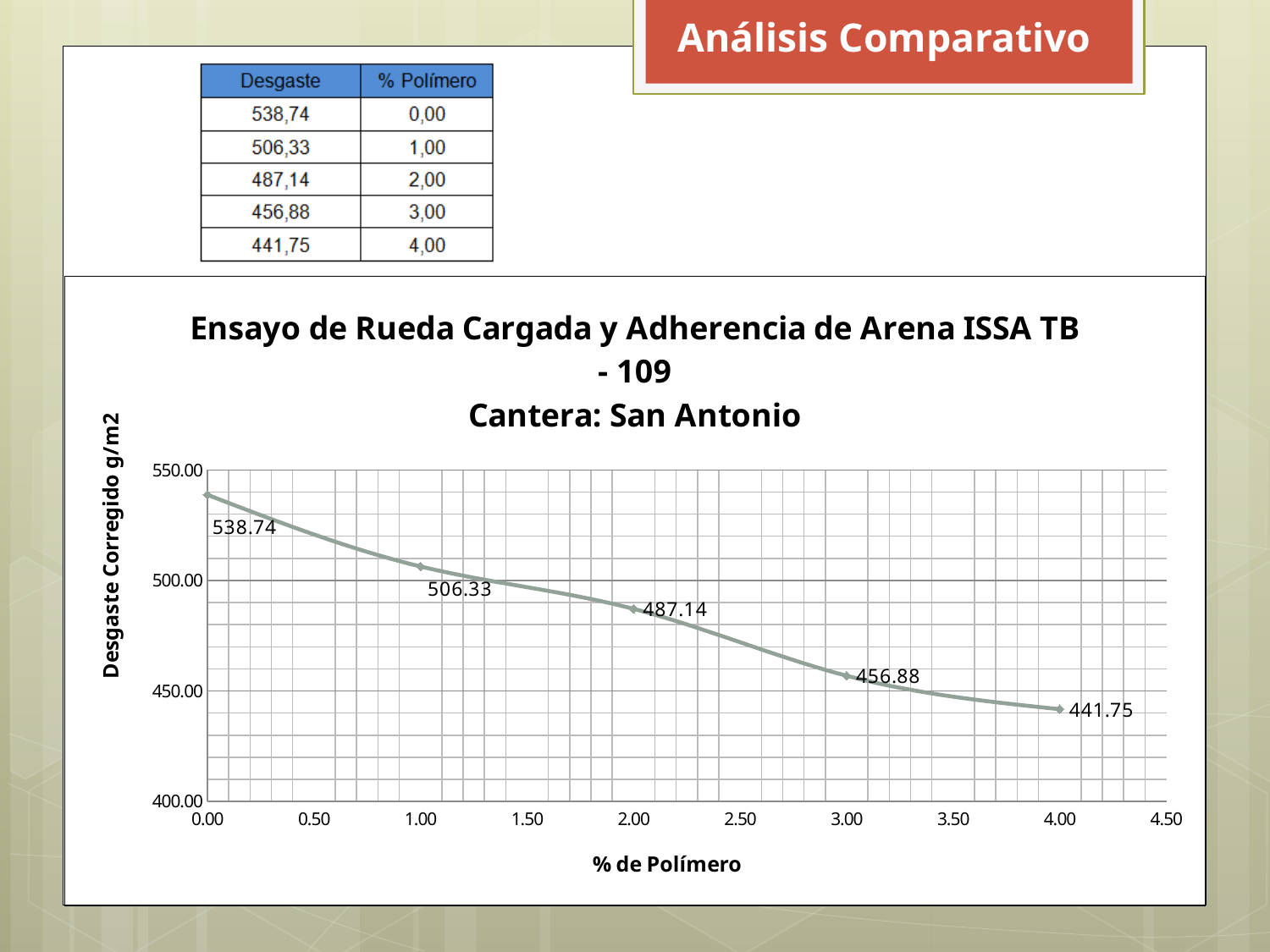
What kind of chart is shown on the slide? line chart Which is larger, the Desgaste Corregido at 1.00 or at 3.00 % de Polímero? 1.00 At which % de Polímero is the Desgaste Corregido lowest? 4.00 What is the Desgaste Corregido value at 0.00 % de Polímero? 538.74 Does the Desgaste Corregido rise or fall as % de Polímero increases? fall What is the difference between the Desgaste Corregido at 1.00 and at 2.00 % de Polímero? 19.19 What is the Desgaste Corregido value at 4.00 % de Polímero? 441.75 Is the Desgaste Corregido at 3.00 % de Polímero greater or less than 500.00? less At which % de Polímero is the Desgaste Corregido highest? 0.00 What is the Desgaste Corregido value at 2.00 % de Polímero? 487.14 How many data points are plotted on the chart? 5 What is the difference between the Desgaste Corregido at 0.00 and at 4.00 % de Polímero? 96.99